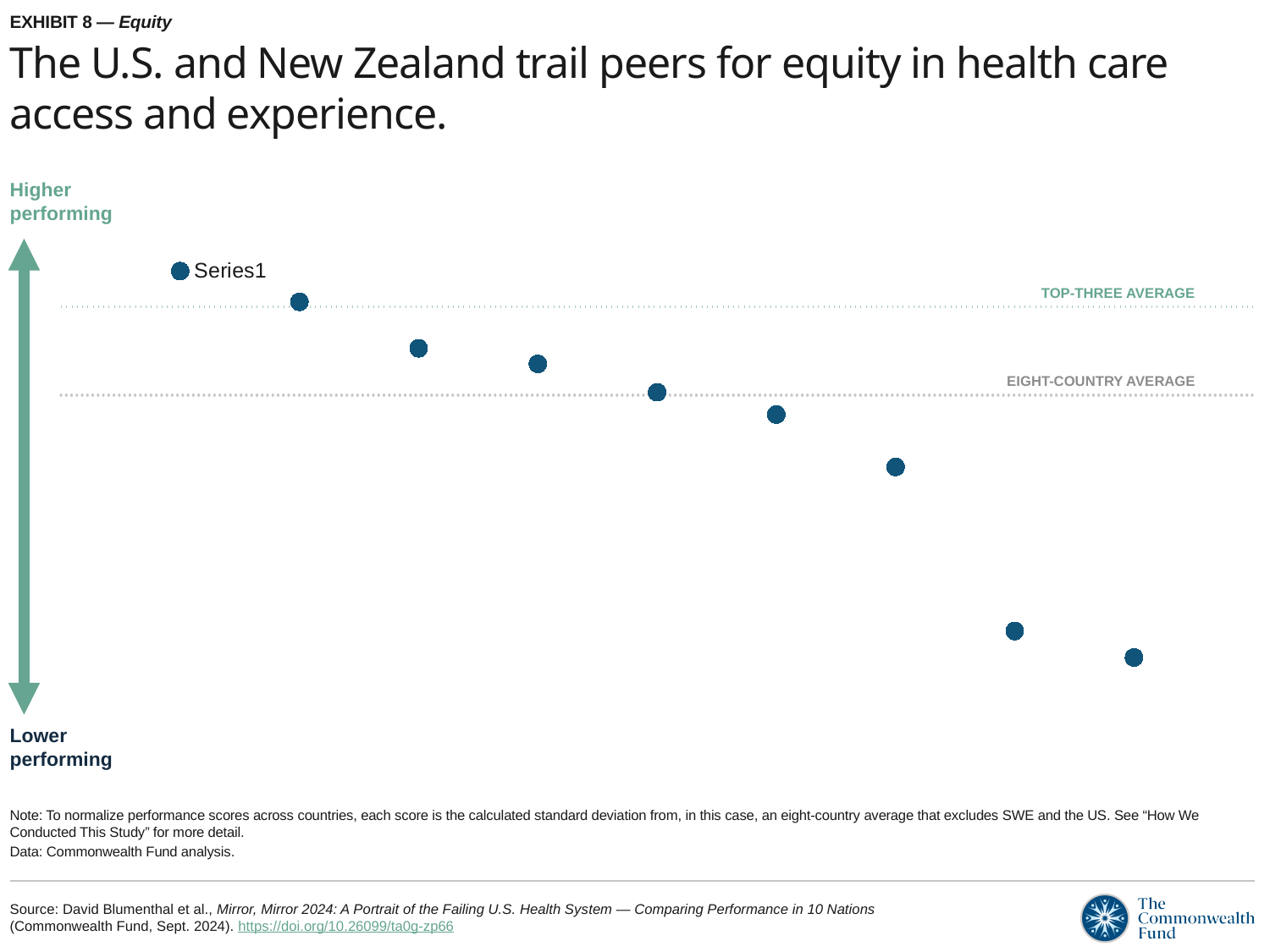
Which plotted point is the lowest on the chart: the leftmost or the rightmost? The rightmost What kind of chart is shown on the slide? Scatter (dot) chart Is the leftmost plotted point higher or lower than the rightmost plotted point? Higher What are the two dotted reference lines on the chart labelled? TOP-THREE AVERAGE and EIGHT-COUNTRY AVERAGE How many plotted points lie clearly below the EIGHT-COUNTRY AVERAGE line? 4 Which plotted point is the highest on the chart: the leftmost or the rightmost? The leftmost Do the plotted values rise or fall from left to right across the chart? Fall How many data points are plotted on the chart? 9